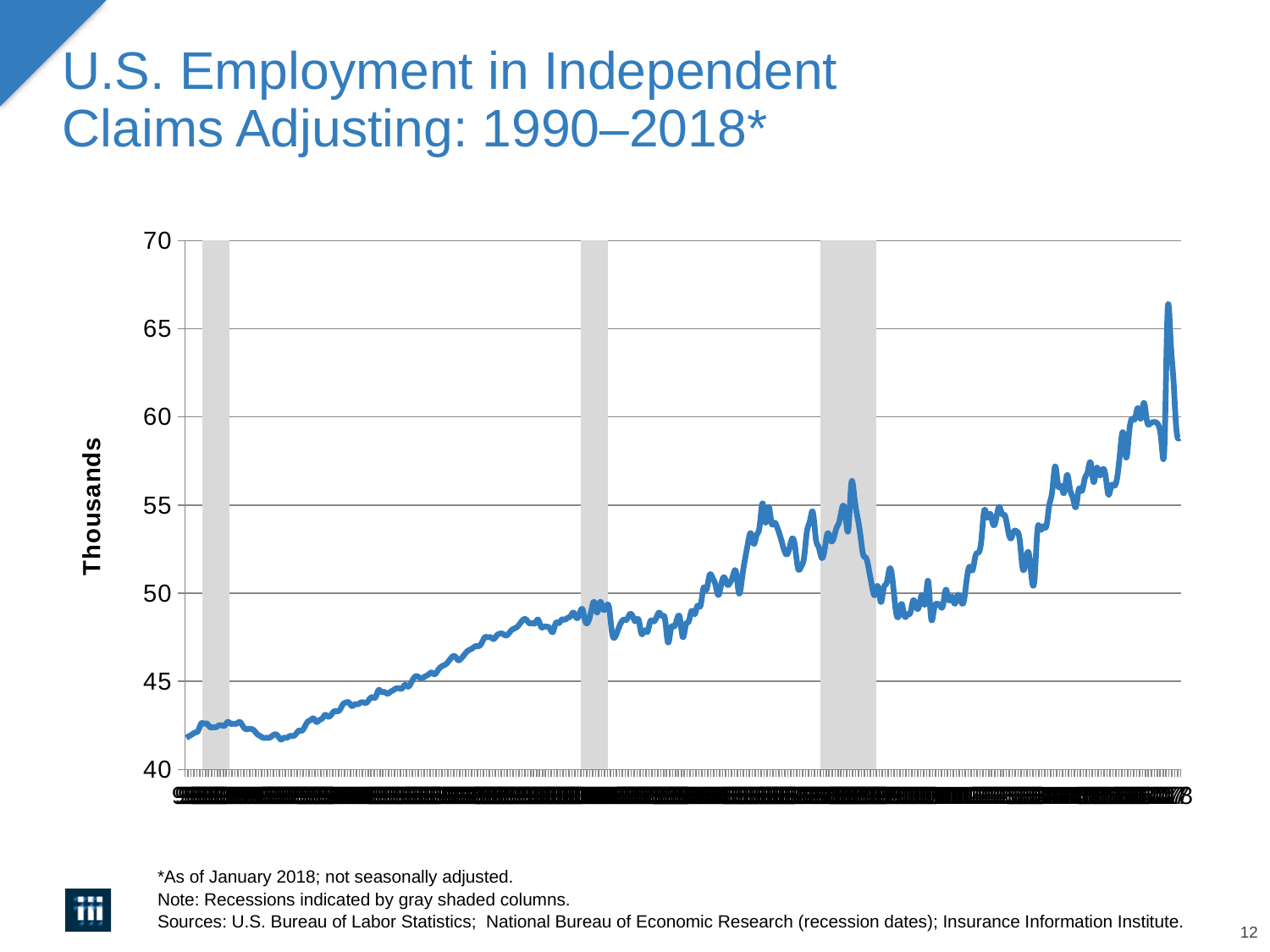
Is the value at the end of the series (right end of the line) greater or less than 60? less Is the value at the start of the series (left end of the line) greater or less than 45? less Overall, do the values rise or fall from the left of the x axis to the right? rise What kind of chart is shown on the slide? line chart Is the lowest point on the line greater or less than 45? less What is the label on the vertical axis? Thousands How many gray shaded recession columns are shown on the chart? 3